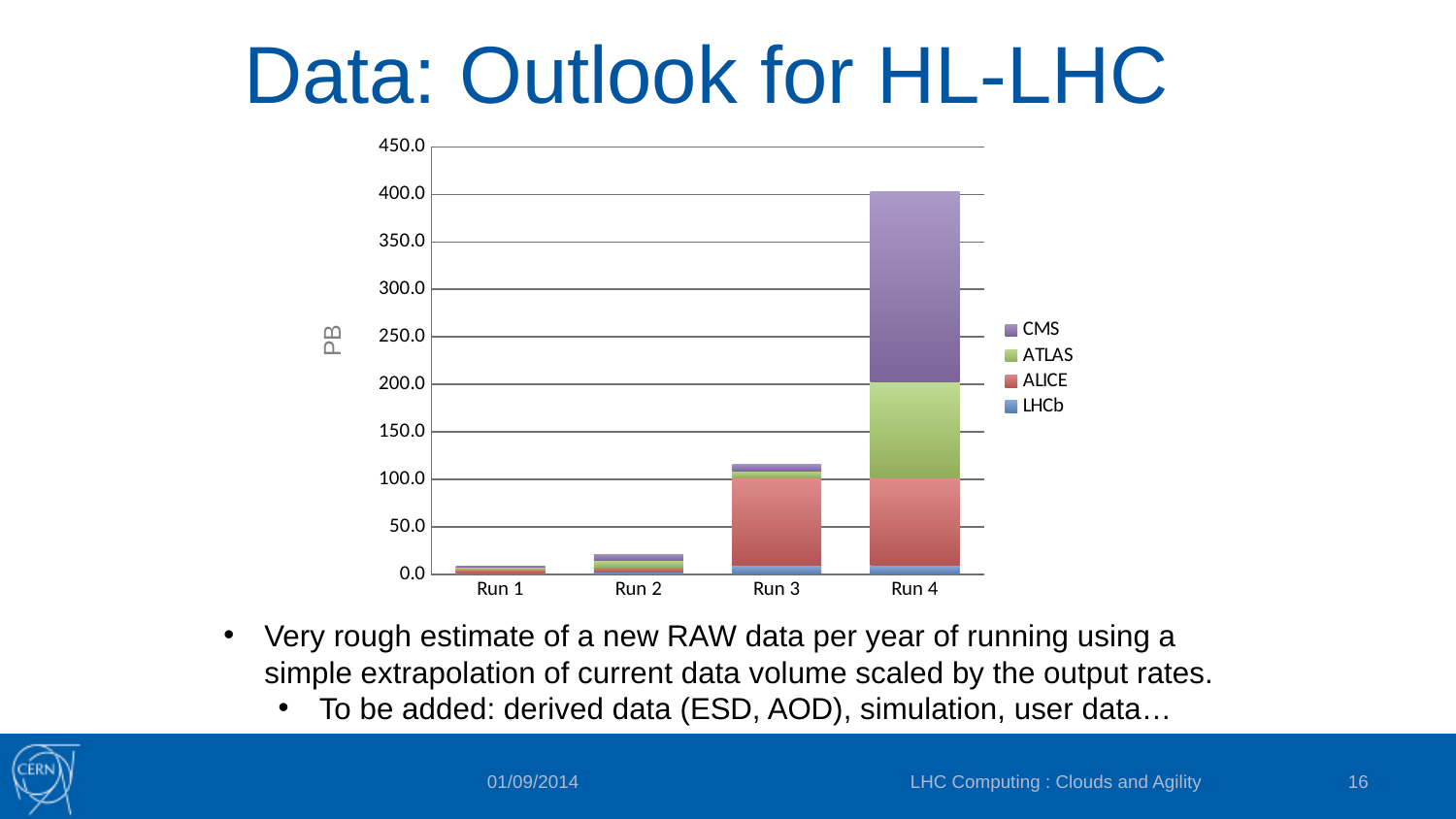
Is the total value for Run 3 greater or less than 100? greater How many runs (categories) are shown on the x axis of the chart? 4 Is the total value for Run 4 greater or less than 350? greater Which has the larger total stacked bar, Run 2 or Run 3? Run 3 How many series does the chart's legend list? 4 What kind of chart is shown on the slide? stacked bar chart Which series is listed first in the chart's legend? CMS Do the total values rise or fall from Run 1 to Run 4? rise Is the total value for Run 2 greater or less than 50? less Which run has the lowest total stacked bar in the chart? Run 1 Which run has the highest total stacked bar in the chart? Run 4 What unit is shown on the y axis of the chart? PB